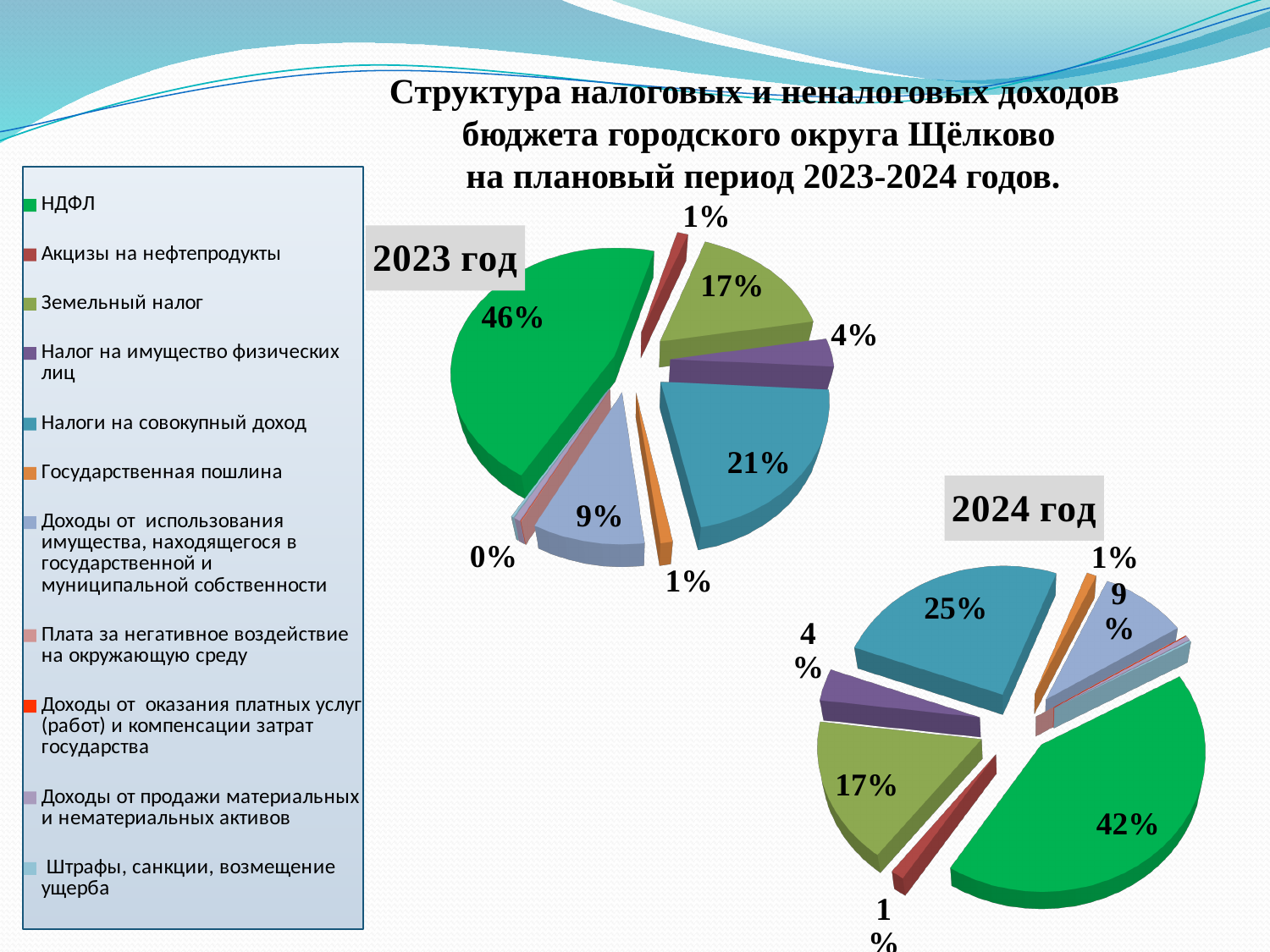
In the 2023 год chart, what is the difference between the НДФЛ share and the Налоги на совокупный доход share? 25% In the 2023 год chart, what share does Доходы от использования имущества, находящегося в государственной и муниципальной собственности (light blue slice) have? 9% What type of charts are shown on the slide? Pie charts Which is larger: the НДФЛ share in the 2023 год chart or in the 2024 год chart? 2023 год In the 2024 год chart, which category has the largest share? НДФЛ In the 2023 год chart, what share does НДФЛ (green slice) have? 46% In the 2023 год chart, what share does Налоги на совокупный доход (teal slice) have? 21% In the 2023 год chart, which category has the largest share? НДФЛ How many entries does the legend list? 11